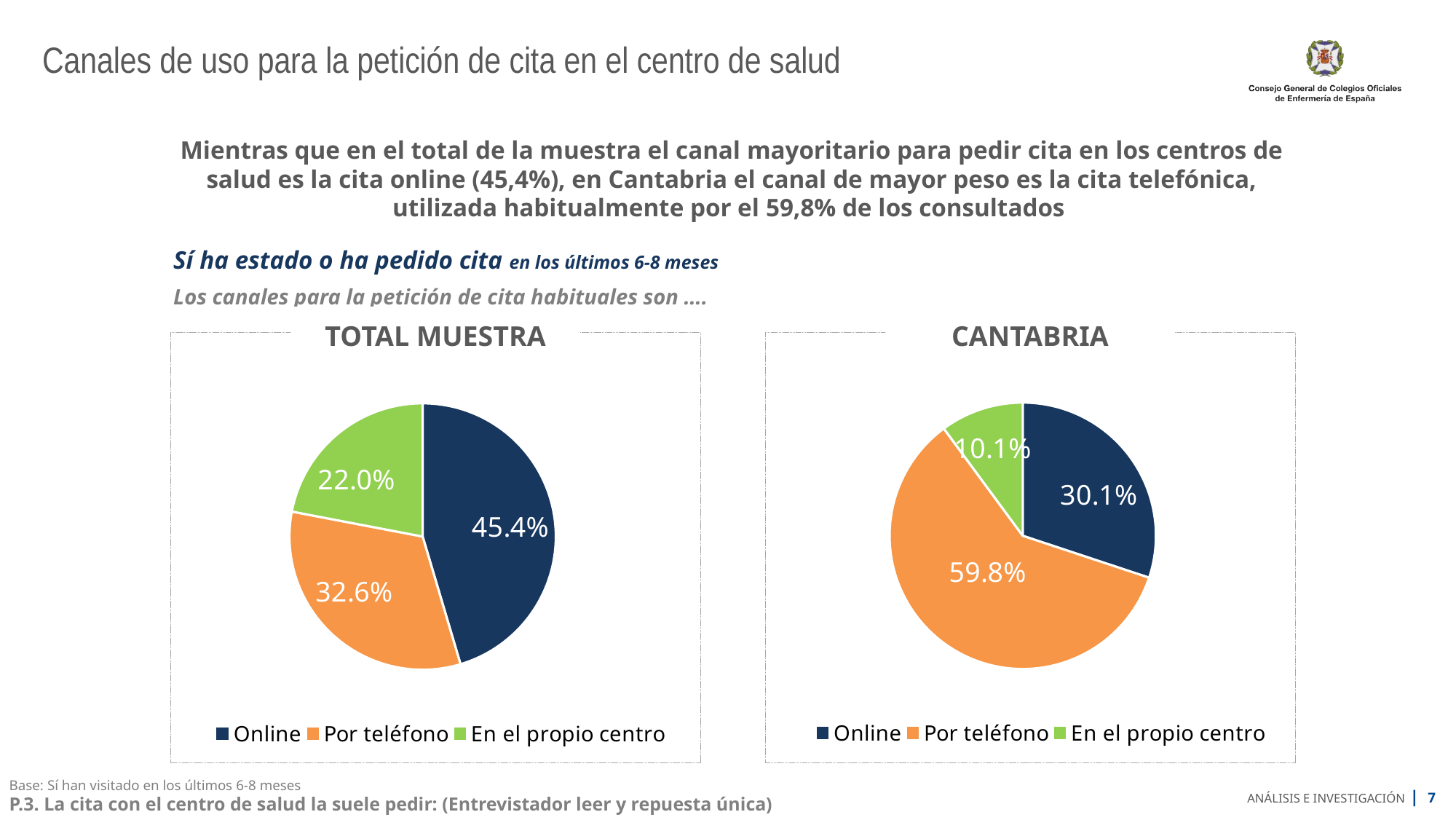
In the CANTABRIA chart, what is the difference between Por teléfono and Online? 29.7% In the CANTABRIA chart, what colour is the Por teléfono slice? Orange In the TOTAL MUESTRA chart, what is the difference between Online and En el propio centro? 23.4% In the CANTABRIA chart, what is the value for En el propio centro? 10.1% In the TOTAL MUESTRA chart, what is the value for Por teléfono? 32.6% In the TOTAL MUESTRA chart, which category has the largest share? Online Which is larger: Online in the TOTAL MUESTRA chart or Online in the CANTABRIA chart? TOTAL MUESTRA In the TOTAL MUESTRA chart, what is the value for Online? 45.4% What type of chart is the TOTAL MUESTRA chart? Pie chart How many slices does the CANTABRIA pie chart have? 3 In the CANTABRIA chart, what is the value for Por teléfono? 59.8% In the CANTABRIA chart, which category has the smallest share? En el propio centro